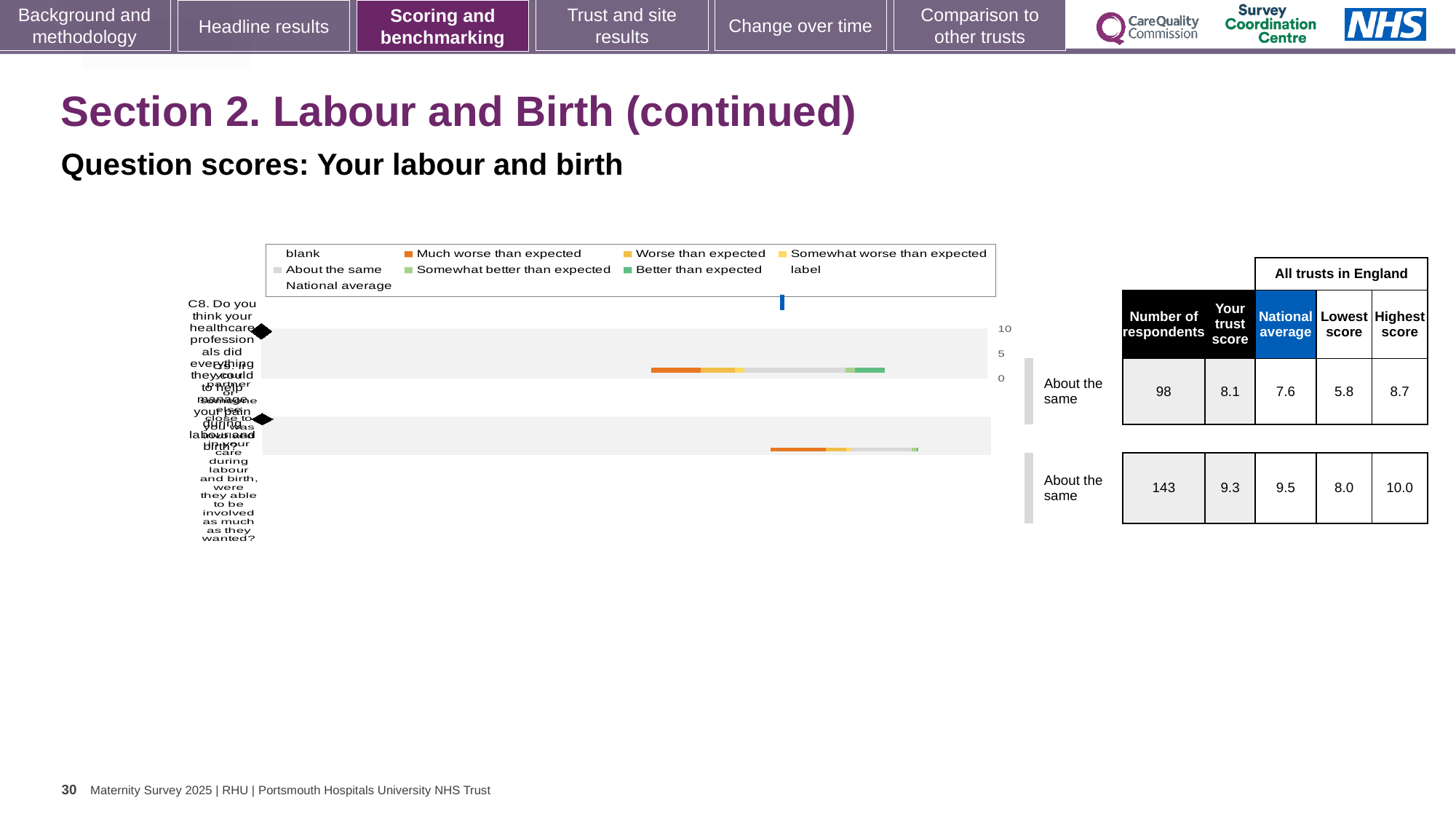
What kind of chart is shown on the slide? bar chart In the legend, which colour represents 'Much worse than expected'? orange For the first question row, what is the difference between the trust score (8.1) and the national average (7.6)? 0.5 In the table beside the chart, what is the number of respondents for the first question row? 98 For the second question row, which is larger: the trust score or the national average? national average Which question row has the higher number of respondents, the first or the second? the second What is the highest value shown on the chart's numeric axis? 10 In the table beside the chart, what is the national average for the second question row? 9.5 In the table beside the chart, what is the highest score among all trusts in England for the second question row? 10.0 For the first question row, which is larger: the trust score or the national average? trust score How many question rows (bars) are plotted in the chart? 2 In the table beside the chart, what is the trust score for the first question row? 8.1